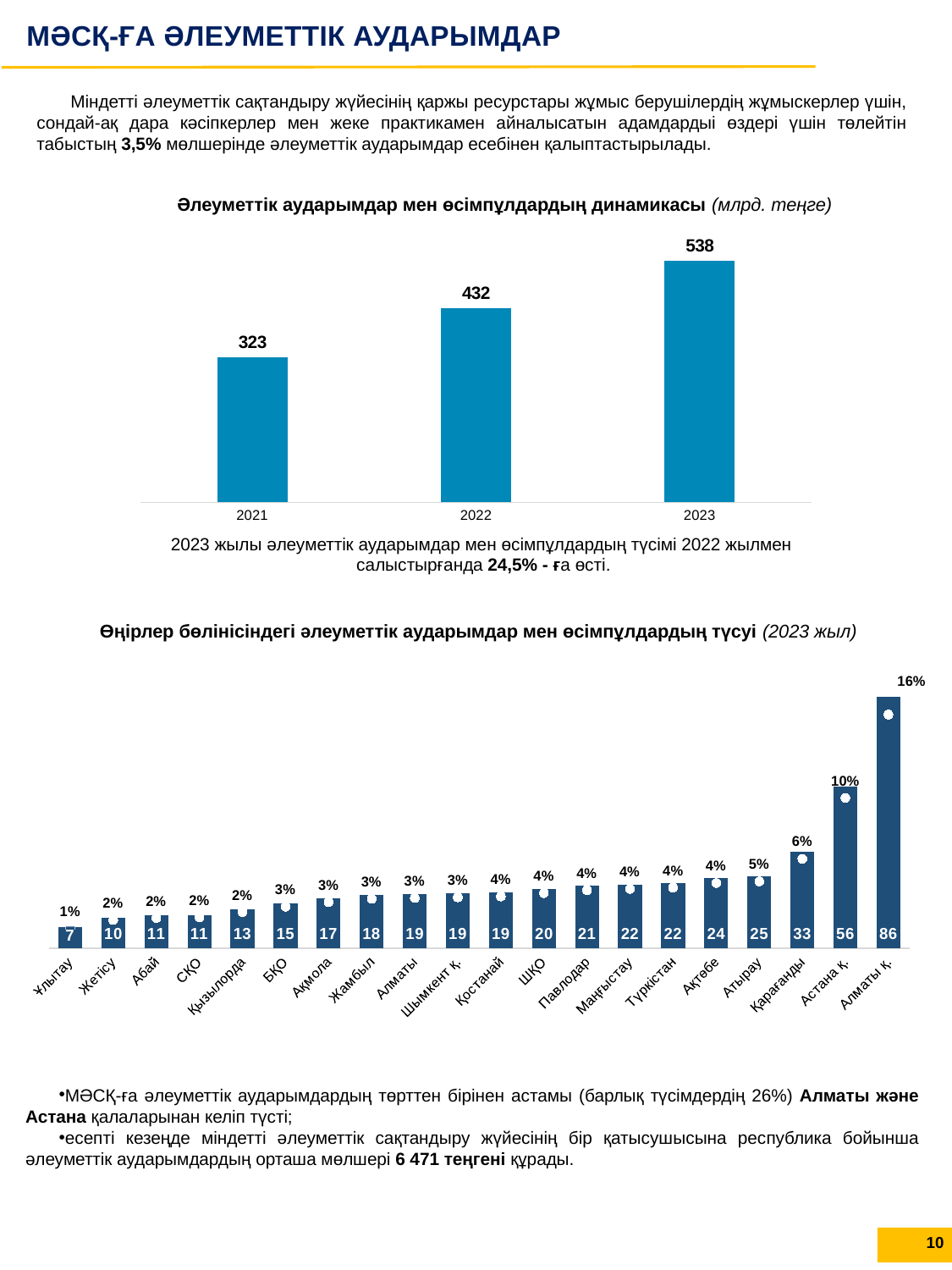
In the chart 'Әлеуметтік аударымдар мен өсімпұлдардың динамикасы', what is the value for 2022? 432 In the chart 'Өңірлер бөлінісіндегі әлеуметтік аударымдар мен өсімпұлдардың түсуі', which region has the highest value? Алматы қ. In the chart 'Әлеуметтік аударымдар мен өсімпұлдардың динамикасы', what unit is given in the title? млрд. теңге In the chart 'Өңірлер бөлінісіндегі әлеуметтік аударымдар мен өсімпұлдардың түсуі', what is the value for Қарағанды? 33 In the chart 'Әлеуметтік аударымдар мен өсімпұлдардың динамикасы', do the values rise or fall from 2021 to 2023? rise In the chart 'Әлеуметтік аударымдар мен өсімпұлдардың динамикасы', what is the difference between the 2023 and 2021 values? 215 In the chart 'Өңірлер бөлінісіндегі әлеуметтік аударымдар мен өсімпұлдардың түсуі', which region has the lowest value? Ұлытау What kind of chart is 'Әлеуметтік аударымдар мен өсімпұлдардың динамикасы'? bar chart In the chart 'Өңірлер бөлінісіндегі әлеуметтік аударымдар мен өсімпұлдардың түсуі', what is the difference between the values for Алматы қ. and Астана қ.? 30 In the chart 'Әлеуметтік аударымдар мен өсімпұлдардың динамикасы', which year has the highest value? 2023 In the chart 'Өңірлер бөлінісіндегі әлеуметтік аударымдар мен өсімпұлдардың түсуі', how many regions are shown? 20 In the chart 'Өңірлер бөлінісіндегі әлеуметтік аударымдар мен өсімпұлдардың түсуі', what percentage share is shown for Астана қ.? 10%